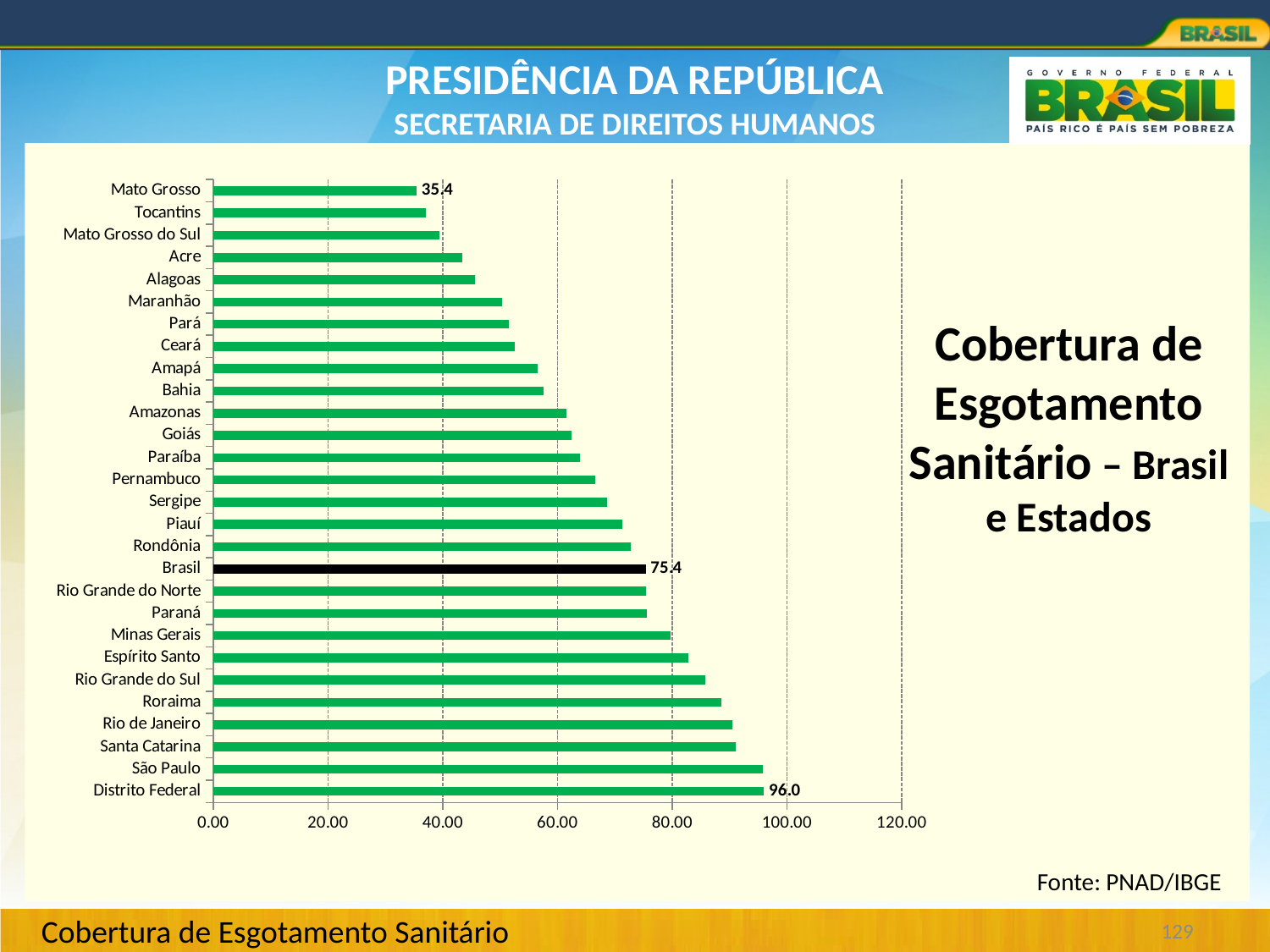
What is the value for Mato Grosso? 35.4 Is the value for Espírito Santo greater or less than 80.00? greater Which category has the highest value? Distrito Federal Which has a larger value, Santa Catarina or Acre? Santa Catarina What is the value for Distrito Federal? 96.0 Which category has the lowest value? Mato Grosso How many bars are plotted in the chart? 28 What is the difference between the values for Distrito Federal and Brasil? 20.6 What type of chart is shown on the slide? bar chart What is the difference between the values for Brasil and Mato Grosso? 40.0 What colour is the bar for Brasil? black What is the value for Brasil? 75.4